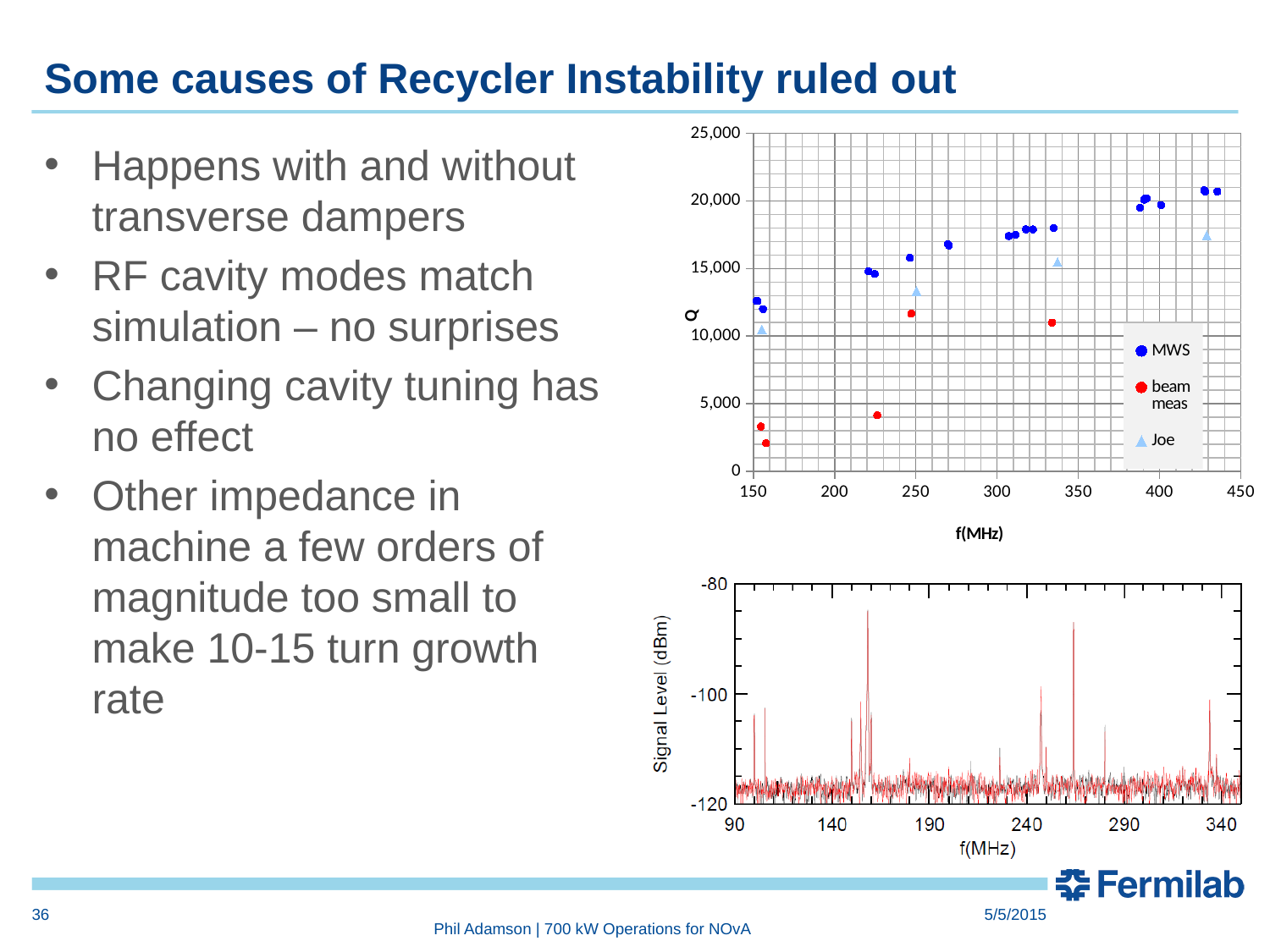
In the top chart (Q versus f(MHz)), is the Joe value near 430 MHz greater or less than 15,000? greater What kind of chart is the top chart on the right (Q versus f(MHz))? scatter plot In the top chart (Q versus f(MHz)), is the MWS value near 270 MHz greater or less than 15,000? greater In the top chart (Q versus f(MHz)), near 335 MHz, which series has the larger Q value: Joe or beam meas? Joe What kind of chart is the bottom chart on the right (Signal Level versus f(MHz))? line chart In the top chart (Q versus f(MHz)), is the beam meas value near 155 MHz greater or less than 5,000? less In the top chart, what is the label of the vertical axis? Q In the top chart (Q versus f(MHz)), what are the three series named in the legend? MWS, beam meas, Joe In the top chart (Q versus f(MHz)), how many series does the legend list? 3 In the top chart (Q versus f(MHz)), near 250 MHz, which series has the larger Q value: MWS or beam meas? MWS In the top chart (Q versus f(MHz)), do the MWS values rise or fall as frequency increases? rise